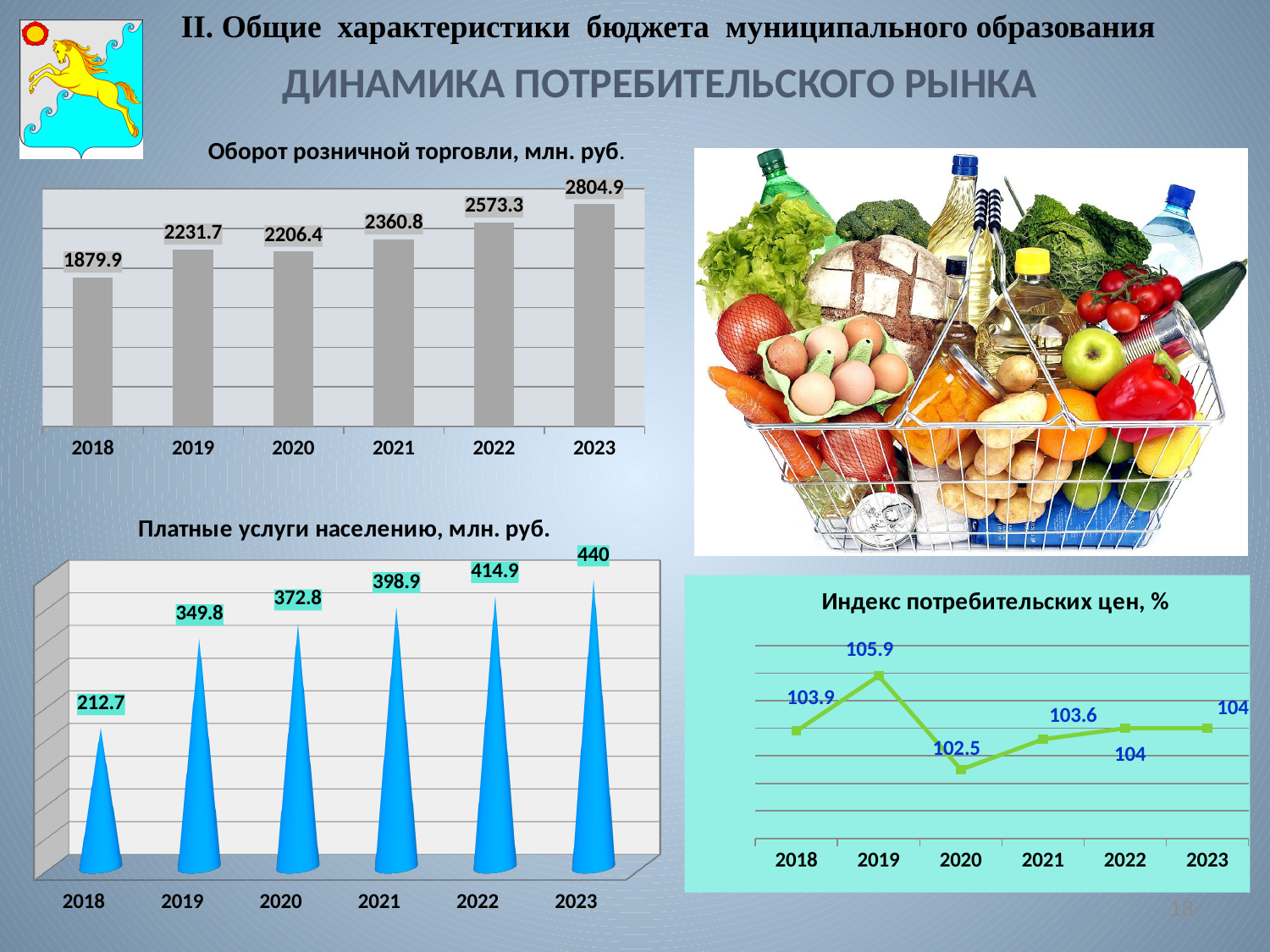
In the chart 'Платные услуги населению, млн. руб.', which year has the highest value? 2023 In the chart 'Платные услуги населению, млн. руб.', what is the value for 2018? 212.7 What kind of chart is 'Оборот розничной торговли, млн. руб.'? bar chart In the chart 'Индекс потребительских цен, %', which year has the highest value? 2019 In the chart 'Платные услуги населению, млн. руб.', do the values rise or fall from 2018 to 2023? rise In the chart 'Оборот розничной торговли, млн. руб.', which year has the lowest value? 2018 In the chart 'Индекс потребительских цен, %', what is the value for 2020? 102.5 In the chart 'Оборот розничной торговли, млн. руб.', what is the value for 2023? 2804.9 What kind of chart is 'Индекс потребительских цен, %'? line chart In the chart 'Оборот розничной торговли, млн. руб.', which is larger, the value for 2019 or the value for 2020? 2019 In the chart 'Оборот розничной торговли, млн. руб.', what is the difference between the 2023 and 2018 values? 925 How many years are shown on the x axis of the chart 'Платные услуги населению, млн. руб.'? 6